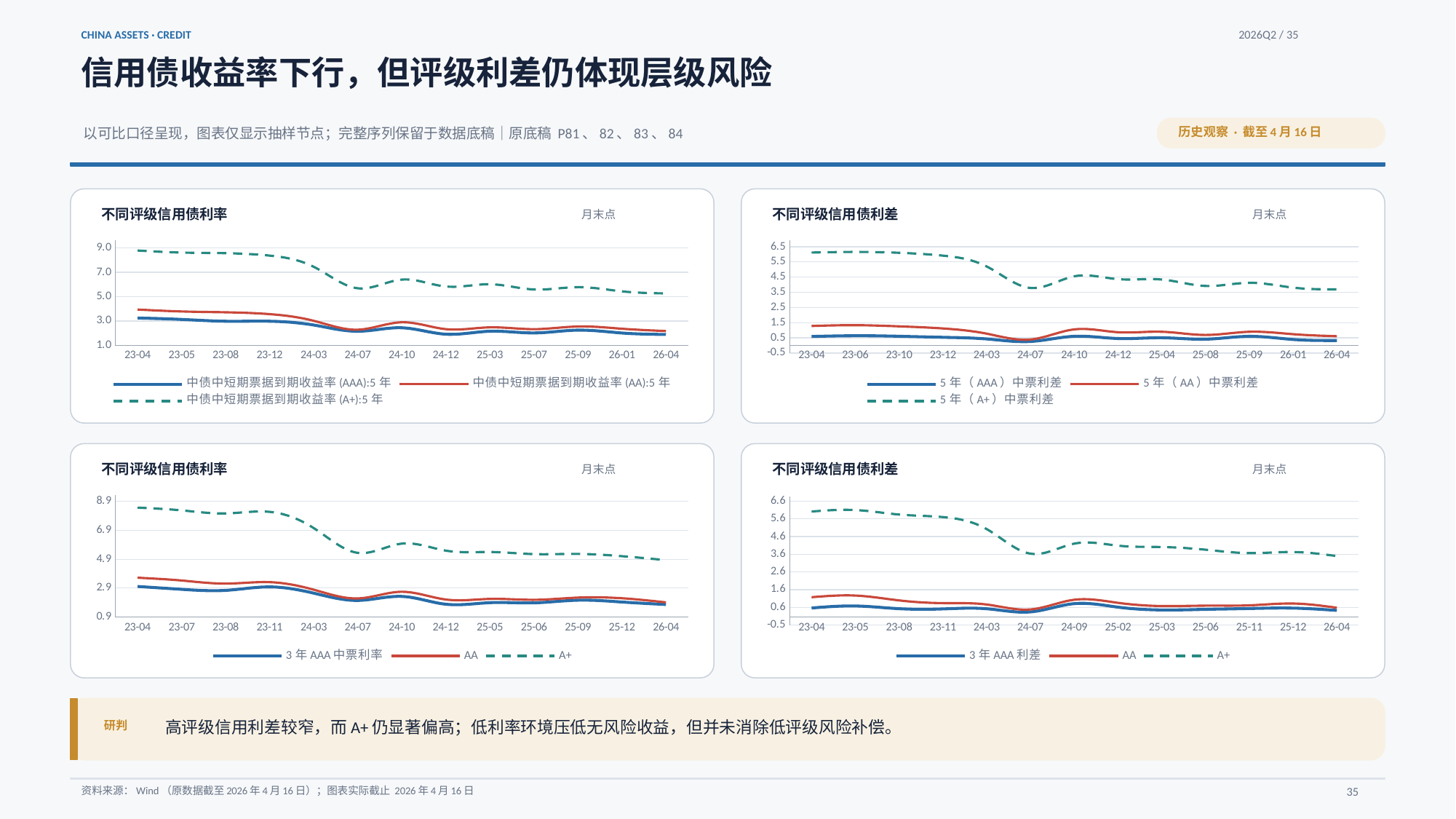
How many x-axis points are shown on the top-right chart (不同评级信用债利差)? 13 In the top-left chart (不同评级信用债利率), which series has the highest values across the whole period? 中债中短期票据到期收益率 (A+):5 年 What is the name of the dashed series in the legend of the bottom-right chart (不同评级信用债利差)? A+ In the bottom-right chart (不同评级信用债利差), is the value of the A+ series at 23-04 greater or less than 5.6? greater In the top-left chart (不同评级信用债利率), is the value of the A+ series at 23-04 greater or less than 7.0? greater In the top-right chart (不同评级信用债利差), which series has the lowest values across the whole period? 5 年（AAA）中票利差 In the bottom-left chart (不同评级信用债利率), does the A+ series rise or fall overall from 23-04 to 26-04? fall How many series does the legend of the top-left chart (不同评级信用债利率) list? 3 In the top-right chart (不同评级信用债利差), is the value of the 5 年（A+）中票利差 series at 23-04 greater or less than 5.5? greater What kind of chart is the top-left chart titled 不同评级信用债利率? line chart What is the title of the top-right chart? 不同评级信用债利差